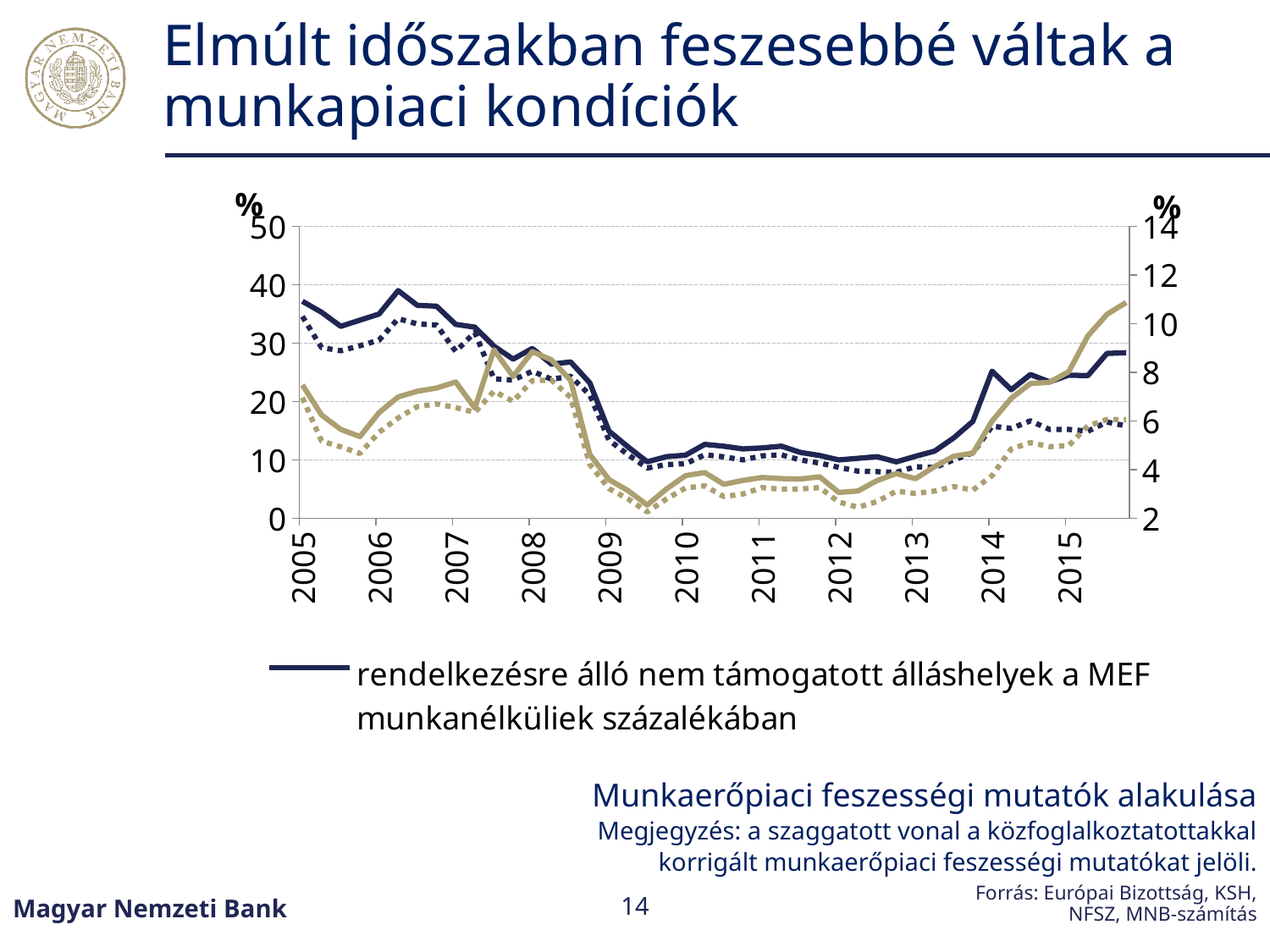
At the start of 2005, is the value of the solid navy line (rendelkezésre álló nem támogatott álláshelyek a MEF munkanélküliek százalékában) greater or less than 30 on the left axis? greater What is the first year labelled on the horizontal axis? 2005 How many lines are plotted on the chart? 4 Does the solid navy line rise or fall between 2008 and 2009? fall Does the solid navy line rise or fall between 2013 and 2015? rise What is the last year labelled on the horizontal axis? 2015 What is the title of the chart, given below it? Munkaerőpiaci feszességi mutatók alakulása What kind of chart is shown on the slide? line chart In 2010, is the value of the solid navy line greater or less than 20 on the left axis? less How many year labels are shown on the horizontal axis? 11 At the start of 2005, is the solid navy line above or below the dotted navy line? above What is the highest tick value on the left vertical axis? 50